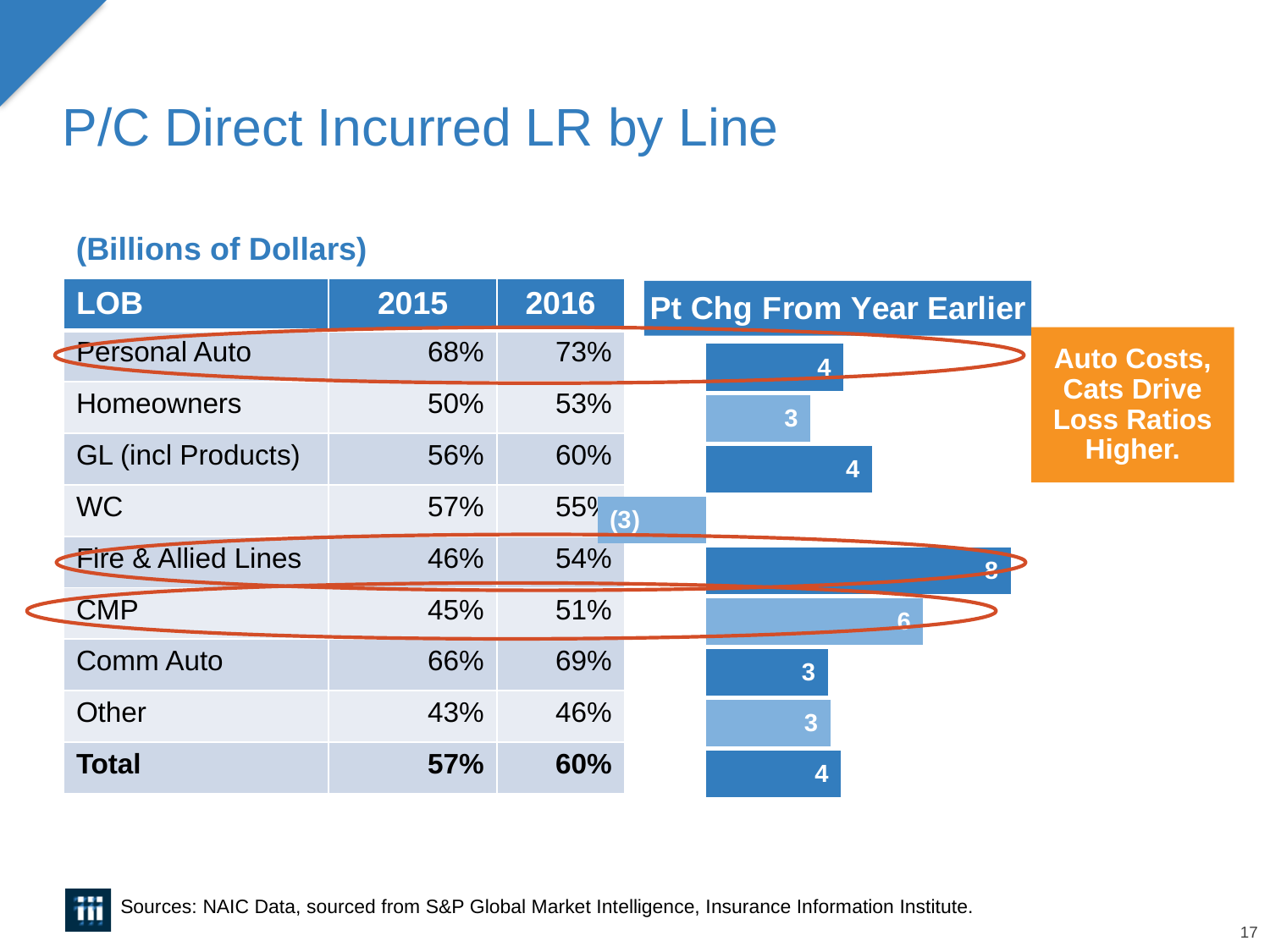
In the 'Pt Chg From Year Earlier' chart, what is the value for WC? (3) In the 'Pt Chg From Year Earlier' chart, what is the value for Total? 4 In the 'Pt Chg From Year Earlier' chart, which is larger, the value for Homeowners or the value for GL (incl Products)? GL (incl Products) In the 'Pt Chg From Year Earlier' chart, which is larger, the value for Personal Auto or the value for Homeowners? Personal Auto In the 'Pt Chg From Year Earlier' chart, what is the difference between the values for Fire & Allied Lines and CMP? 2 How many bars are plotted in the 'Pt Chg From Year Earlier' chart? 9 What is the title of the chart on the slide? Pt Chg From Year Earlier In the 'Pt Chg From Year Earlier' chart, which line of business has the largest point change? Fire & Allied Lines In the 'Pt Chg From Year Earlier' chart, what is the value for Personal Auto? 4 What kind of chart is the 'Pt Chg From Year Earlier' chart? Bar chart In the 'Pt Chg From Year Earlier' chart, which line of business has the lowest point change? WC In the 'Pt Chg From Year Earlier' chart, what is the value for Comm Auto? 3